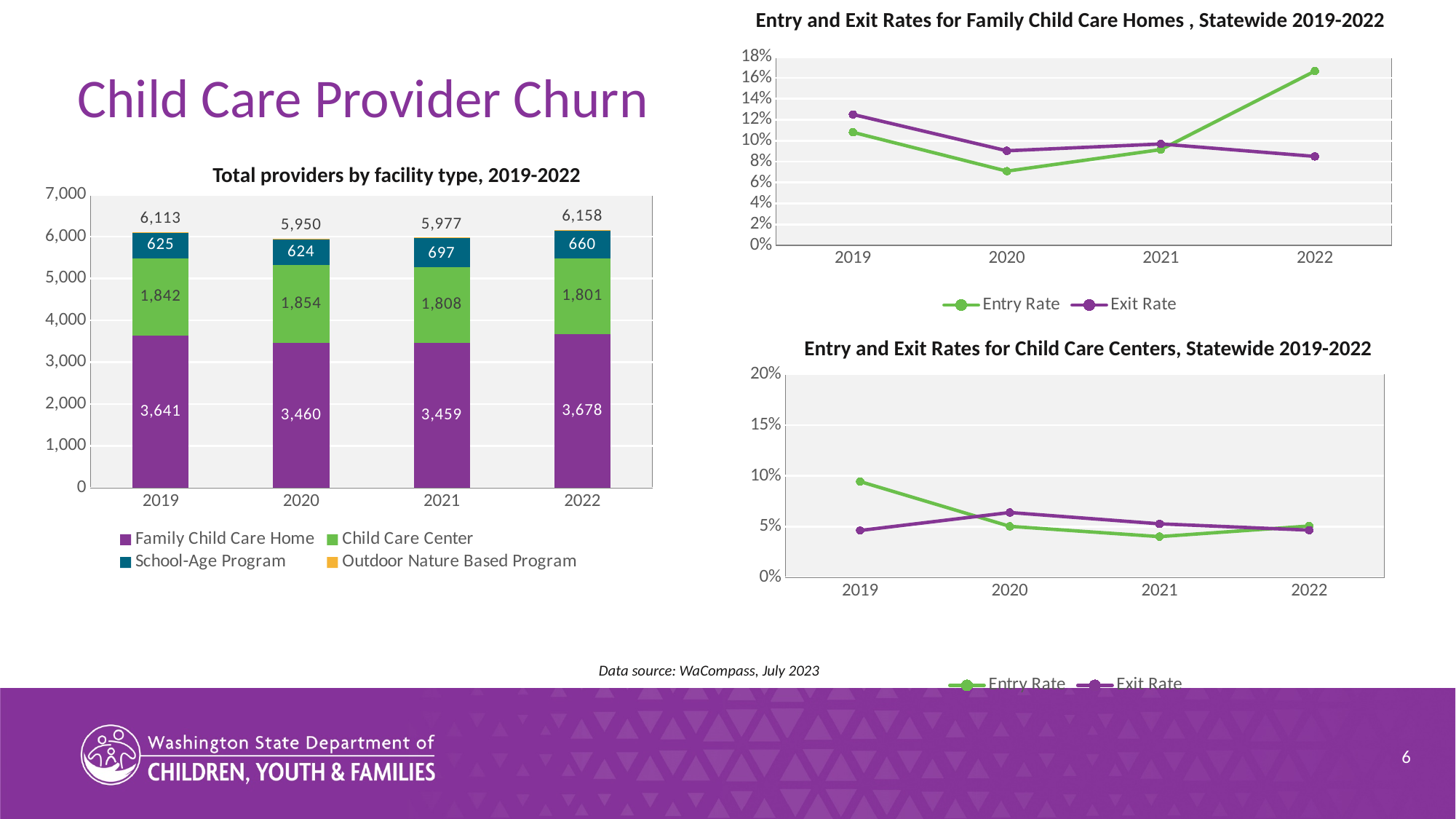
What kind of chart is 'Total providers by facility type, 2019-2022'? Stacked bar chart In the 'Entry and Exit Rates for Family Child Care Homes, Statewide 2019-2022' chart, in which year is the Entry Rate highest? 2022 In the 'Total providers by facility type, 2019-2022' chart, how many School-Age Program providers were there in 2021? 697 In the 'Total providers by facility type, 2019-2022' chart, how many Family Child Care Home providers were there in 2020? 3,460 In the 'Total providers by facility type, 2019-2022' chart, what is the total number of providers in 2022? 6,158 In the 'Total providers by facility type, 2019-2022' chart, what is the difference between the Child Care Center values for 2020 and 2022? 53 In the 'Entry and Exit Rates for Family Child Care Homes, Statewide 2019-2022' chart, which series has the higher value in 2019? Exit Rate In the 'Entry and Exit Rates for Child Care Centers, Statewide 2019-2022' chart, does the Entry Rate rise or fall from 2019 to 2021? fall In the 'Entry and Exit Rates for Child Care Centers, Statewide 2019-2022' chart, is the Entry Rate for 2019 greater or less than 10%? less In the 'Total providers by facility type, 2019-2022' chart, which year has the lowest total number of providers? 2020 In the 'Entry and Exit Rates for Family Child Care Homes, Statewide 2019-2022' chart, is the Entry Rate for 2022 greater or less than 14%? greater In the 'Total providers by facility type, 2019-2022' chart, how many series does the legend list? 4